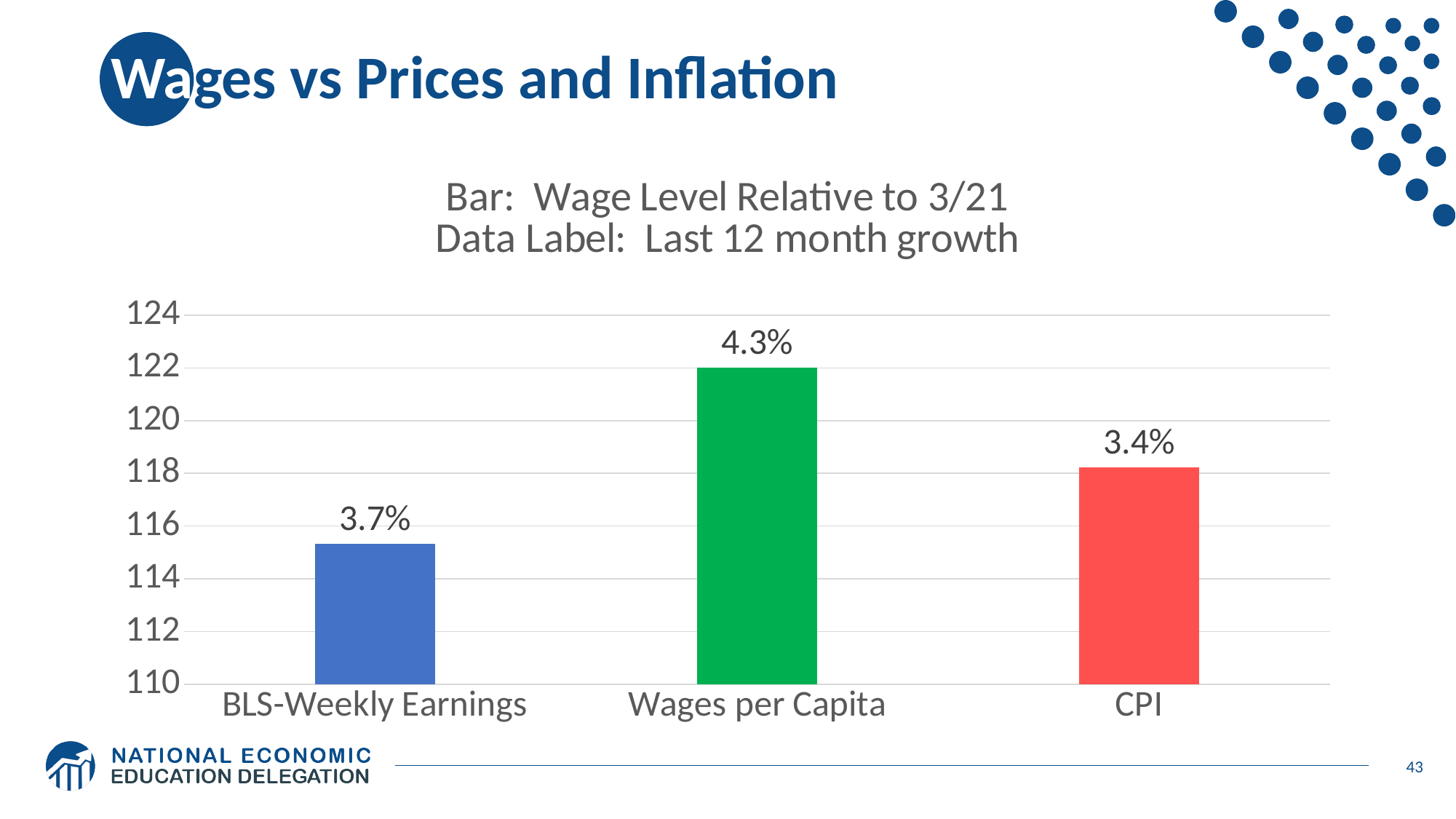
Is the bar height (wage level relative to 3/21) for Wages per Capita greater or less than 120? greater Which has the larger growth data label, BLS-Weekly Earnings or CPI? BLS-Weekly Earnings How many categories are plotted on the chart? 3 What kind of chart is shown on the slide? Bar chart What is the data label (last 12 month growth) shown for Wages per Capita? 4.3% What is the difference between the growth data labels for Wages per Capita and BLS-Weekly Earnings? 0.6% What is the data label (last 12 month growth) shown for CPI? 3.4% Which category has the lowest last 12 month growth data label? CPI Is the bar height (wage level relative to 3/21) for BLS-Weekly Earnings greater or less than 116? less What is the data label (last 12 month growth) shown for BLS-Weekly Earnings? 3.7% Which category has the highest last 12 month growth data label? Wages per Capita